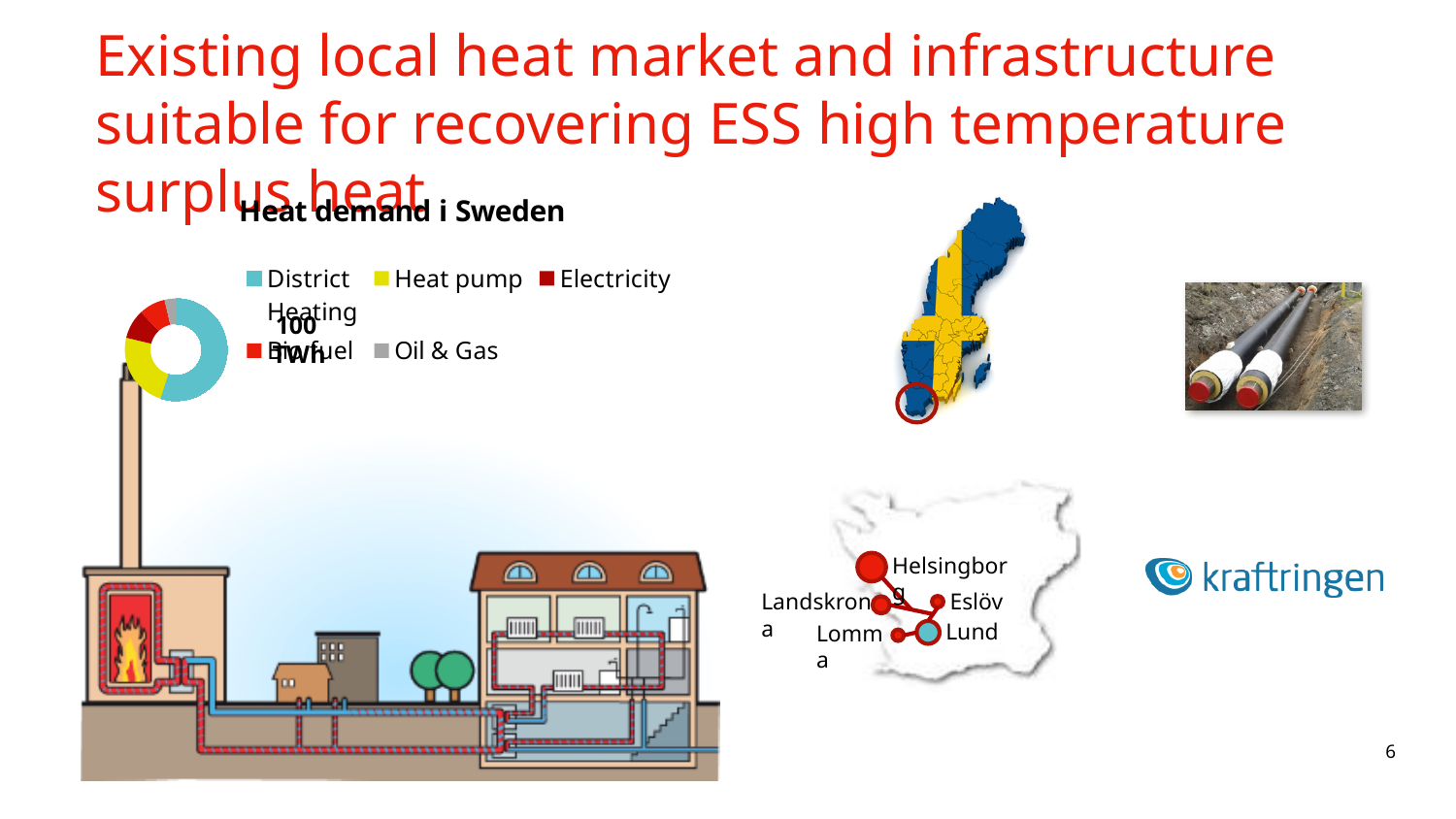
In the "Heat demand i Sweden" chart, which is larger: Heat pump or Oil & Gas? Heat pump What total value is printed in the centre of the "Heat demand i Sweden" chart? 100 TWh What kind of chart is shown under the heading "Heat demand i Sweden"? Doughnut (pie) chart In the "Heat demand i Sweden" chart, which is larger: District Heating or Heat pump? District Heating Does District Heating account for more or less than half of the "Heat demand i Sweden" doughnut? more How many categories does the legend of the "Heat demand i Sweden" chart list? 5 Which category has the largest share in the "Heat demand i Sweden" chart? District Heating What is the title of the doughnut chart on the slide? Heat demand i Sweden